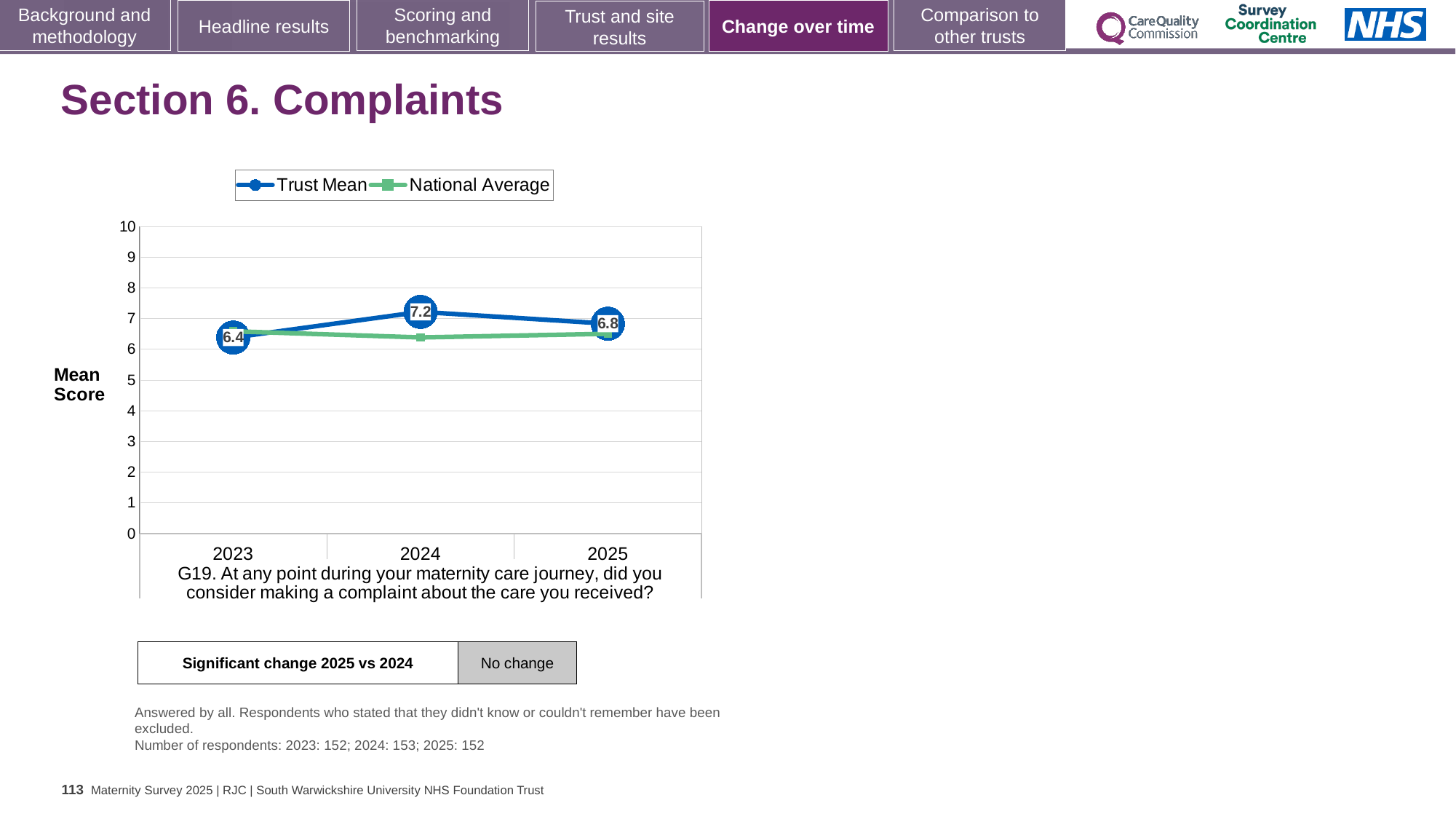
How many years are plotted on the x axis? 3 How many series does the legend list? 2 What is the Trust Mean value for 2024? 7.2 Which year has the larger Trust Mean, 2023 or 2025? 2025 What is the Trust Mean value for 2023? 6.4 What is the difference between the Trust Mean in 2024 and in 2023? 0.8 What kind of chart is shown on the slide? Line chart What is the Trust Mean value for 2025? 6.8 In which year is the Trust Mean highest? 2024 Is the National Average value for 2024 greater or less than 5? greater In which year is the Trust Mean lowest? 2023 What is the label on the y axis of the chart? Mean Score